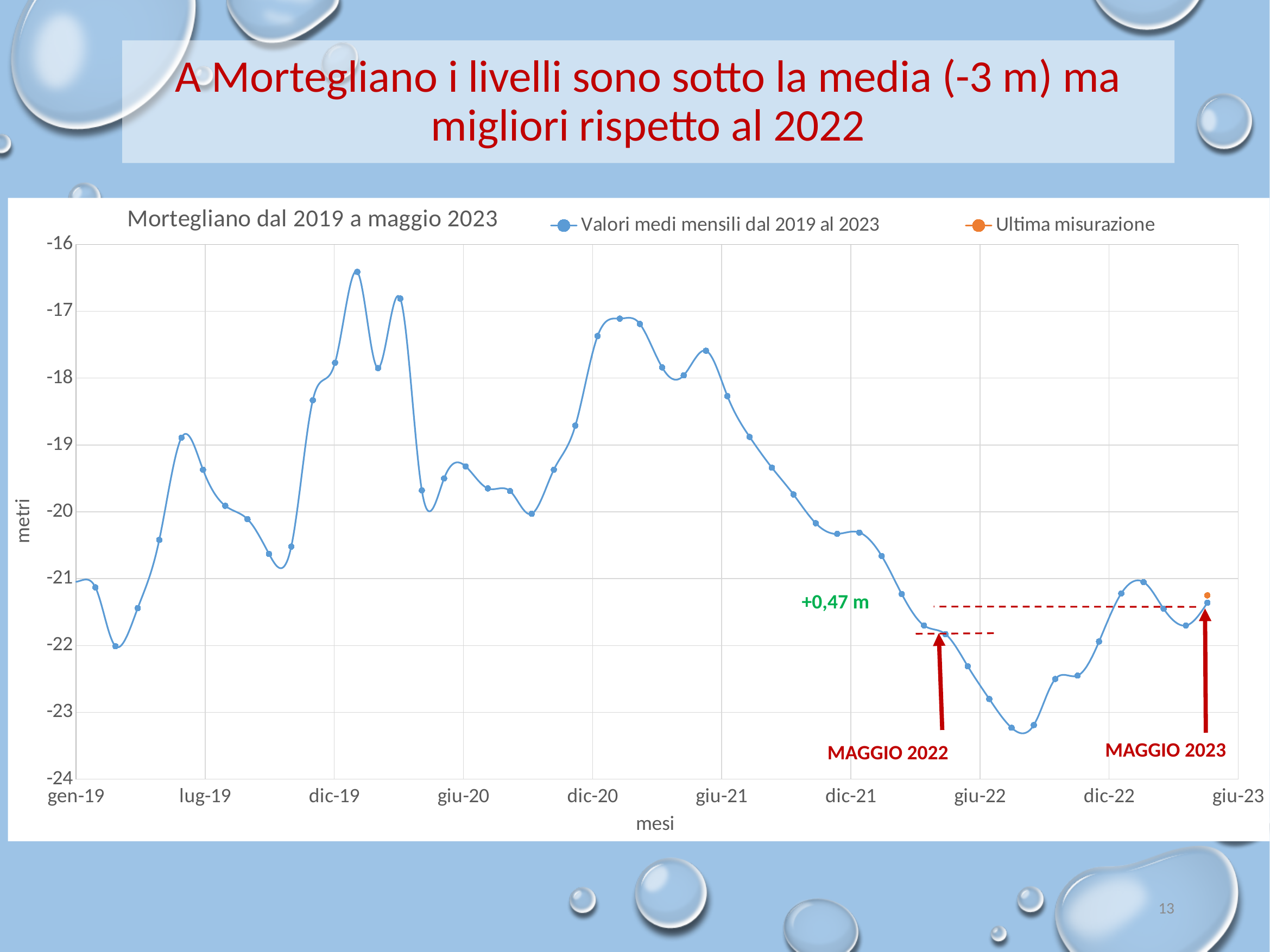
Which is higher, the value for dic-19 or the value for dic-21? dic-19 What is the title of the chart? Mortegliano dal 2019 a maggio 2023 What kind of chart is shown on the slide? line chart Is the value for gen-19 greater or less than -22? greater Do the values rise or fall between giu-21 and giu-22? fall Is the value for dic-21 greater or less than -20? less What is the label of the y axis? metri How many series does the chart legend list? 2 According to the annotation on the chart, by how much did the level improve between MAGGIO 2022 and MAGGIO 2023? +0,47 m Is the highest value on the chart greater or less than -17? greater